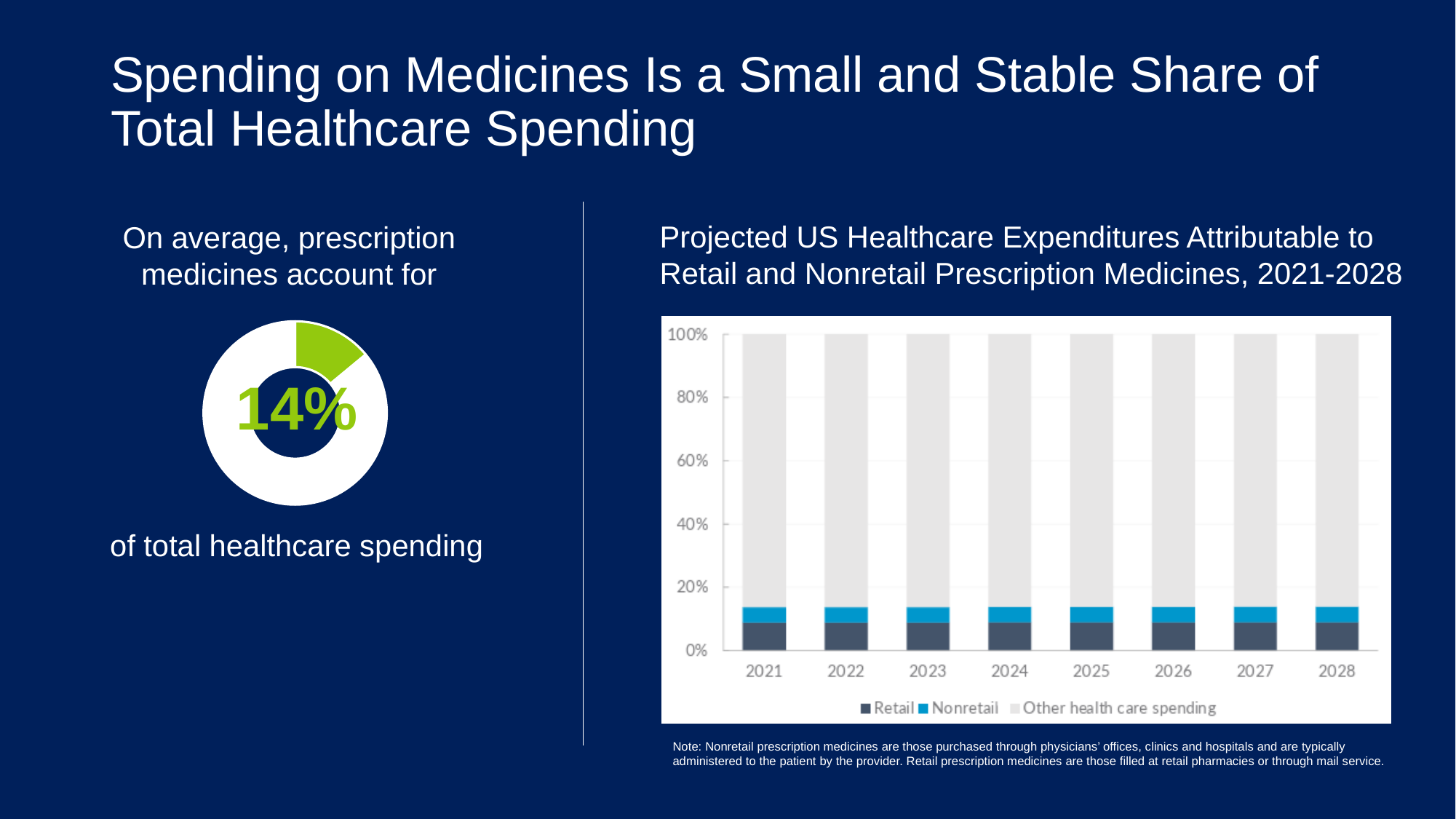
What kind of chart is shown on the left side of the slide? donut chart In the stacked bar chart on the right, which series is the largest in 2025? Other health care spending What kind of chart is shown on the right side of the slide? stacked bar chart In the stacked bar chart on the right, is the value for Other health care spending in 2028 greater or less than 80%? greater In the stacked bar chart on the right, do the combined Retail and Nonretail shares rise, fall, or stay roughly flat from 2021 to 2028? stay roughly flat In the stacked bar chart on the right, is the value for Retail in 2021 greater or less than 20%? less In the donut chart on the left, what share of total healthcare spending do prescription medicines account for? 14% In the stacked bar chart on the right, how many series does the legend list? 3 In the stacked bar chart on the right, what are the three series listed in the legend? Retail, Nonretail, Other health care spending In the stacked bar chart on the right, what is the total height of each stacked bar? 100% In the stacked bar chart on the right, how many years are shown on the x axis? 8 In the stacked bar chart on the right, what is the first year shown on the x axis? 2021